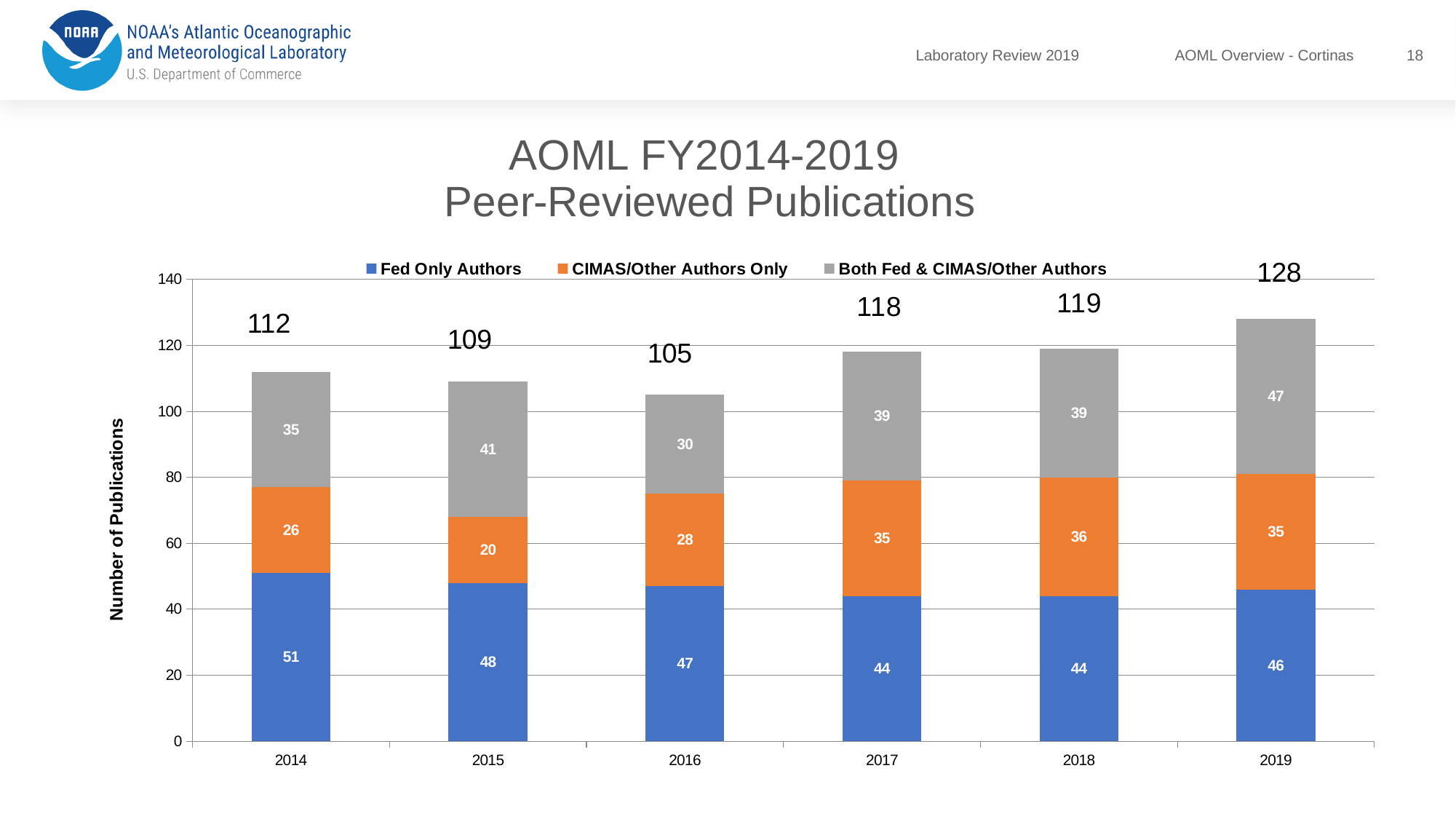
Which year has the lowest total number of publications? 2016 What is the value for Both Fed & CIMAS/Other Authors in 2019? 47 Which colour represents Fed Only Authors in the chart? Blue What is the value for CIMAS/Other Authors Only in 2018? 36 How many series does the legend list? 3 Which year has the highest total number of publications? 2019 What is the value for Fed Only Authors in 2014? 51 Which is larger, the Both Fed & CIMAS/Other Authors value in 2015 or in 2016? 2015 What kind of chart is shown on the slide? Stacked bar chart How many years are shown on the x axis? 6 What is the total of the stacked bar for 2017? 118 What is the difference between the total publications in 2019 and 2018? 9